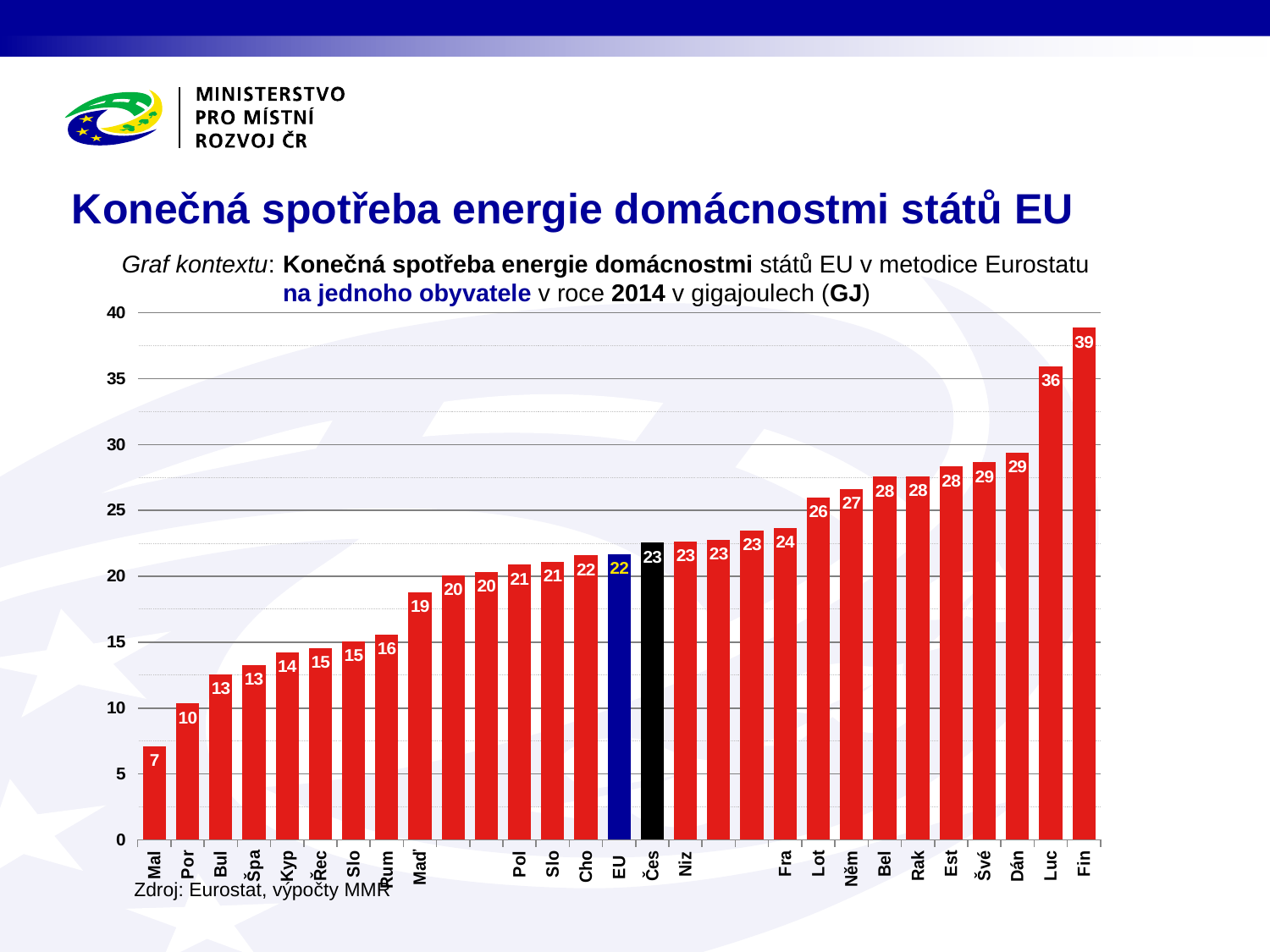
What is the difference between the values for Fin and Mal? 32 What is the difference between the values for Fin and Luc? 3 What is the value shown for Mal? 7 What is the value shown for Čes? 23 Which country has the lowest value in the chart? Mal What is the value shown for the EU bar? 22 What kind of chart is shown on the slide? bar chart Which country has the highest final household energy consumption per capita in the chart? Fin Is the value for Lot greater or less than 25? greater What is the value shown for Fin? 39 Which has a larger value, Luc or Dán? Luc Do the values rise or fall from left to right along the x axis? rise